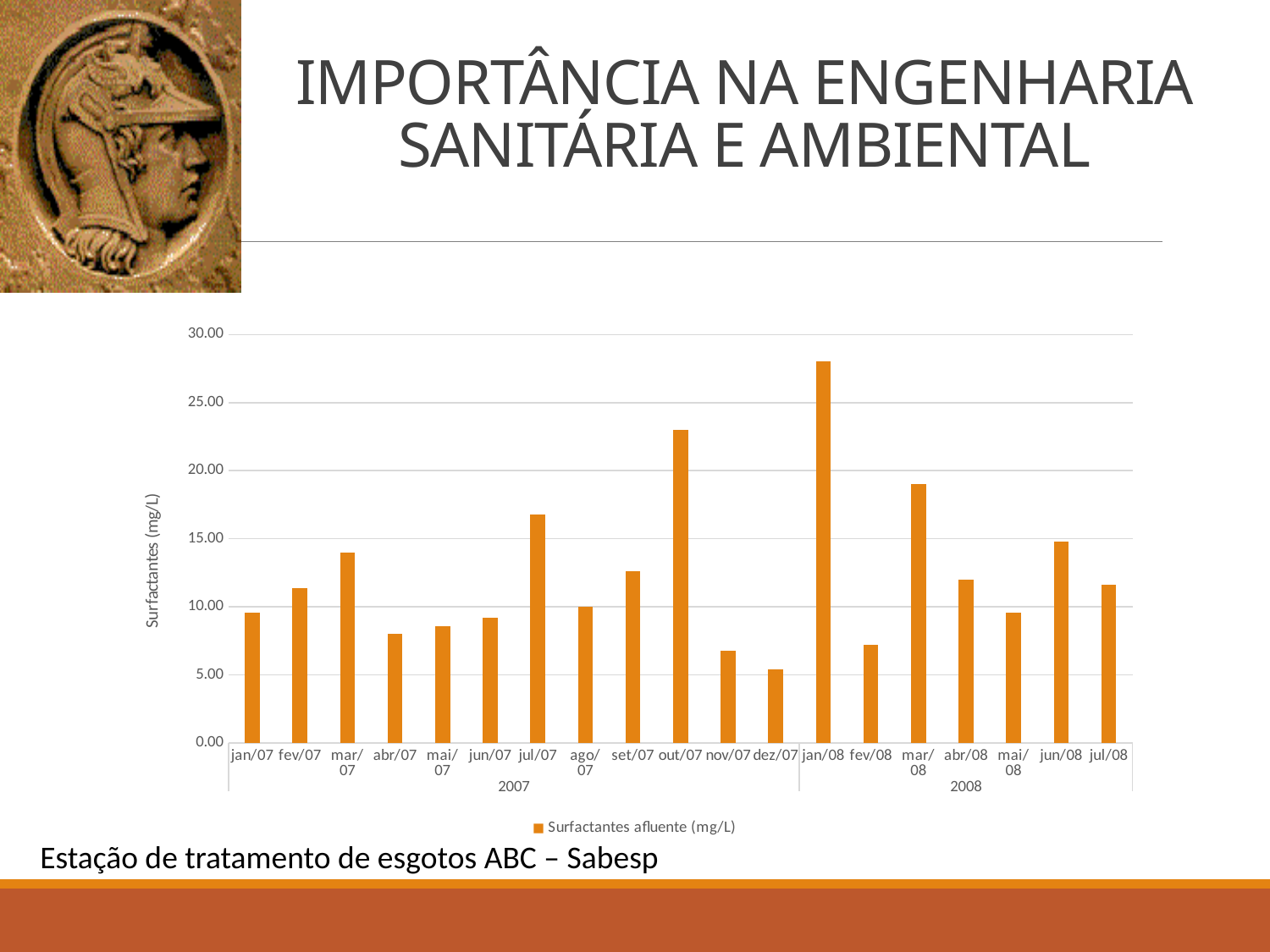
Which month has the lowest surfactant value? dez/07 Is the value for mar/08 greater or less than 20.00? less Is the value for out/07 greater or less than 20.00? greater What is the label of the vertical axis? Surfactantes (mg/L) Which month has the highest surfactant value? jan/08 Which is larger, the value for jul/07 or the value for set/07? jul/07 Which is larger, the value for out/07 or the value for mar/08? out/07 Is the value for abr/07 greater or less than 10.00? less What kind of chart is shown on the slide? bar chart How many series does the legend list? 1 How many months (bars) are plotted in the chart? 19